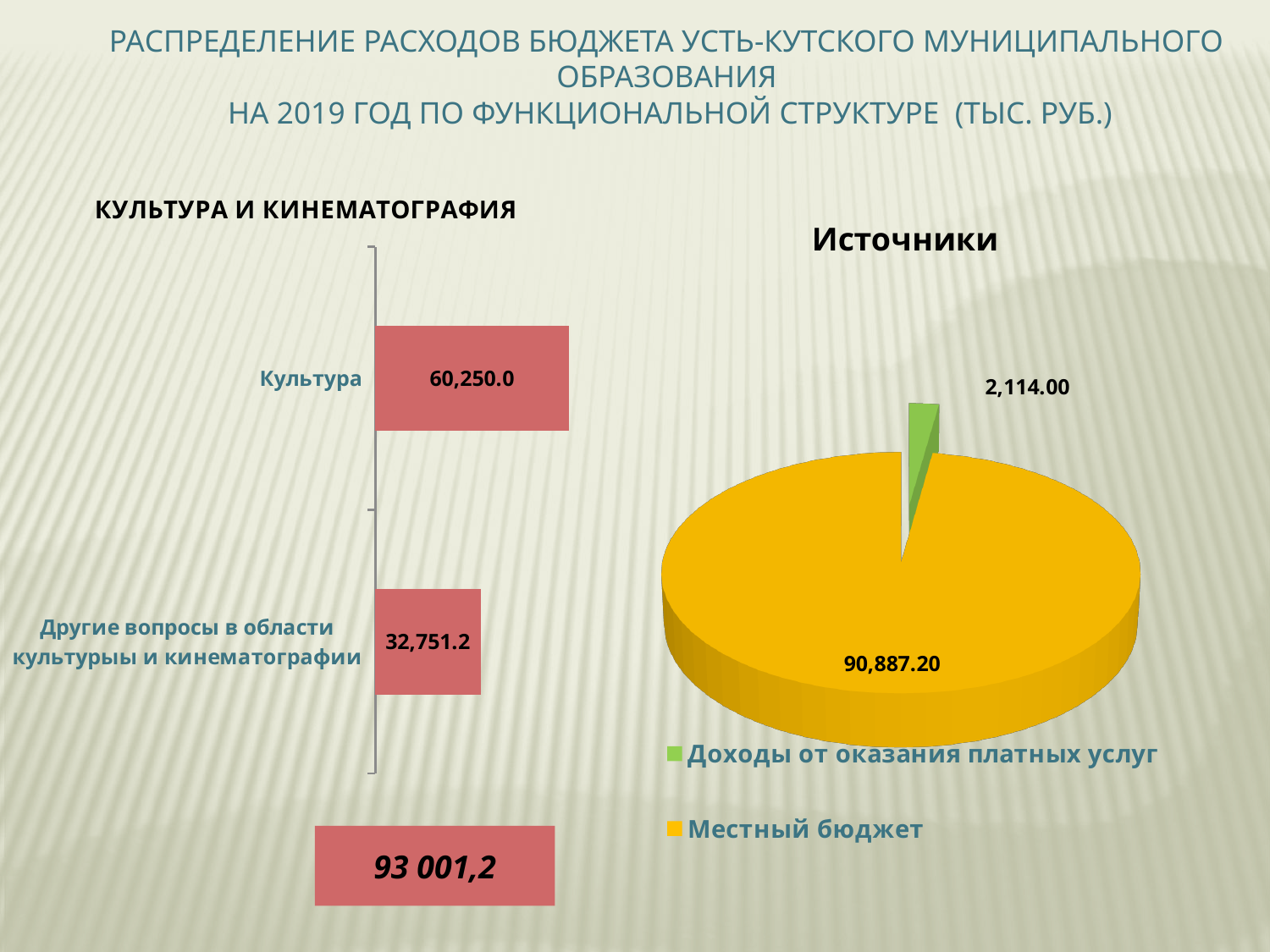
In the chart titled «Источники», what is the value for «Доходы от оказания платных услуг»? 2,114.00 In the chart titled «Источники», what is the value for «Местный бюджет»? 90,887.20 In the chart titled «КУЛЬТУРА И КИНЕМАТОГРАФИЯ», what is the difference between the value for «Культура» and the value for «Другие вопросы в области культурыы и кинематографии»? 27,498.8 In the chart titled «КУЛЬТУРА И КИНЕМАТОГРАФИЯ», which category has the highest value? Культура In the chart titled «КУЛЬТУРА И КИНЕМАТОГРАФИЯ», what is the value for «Другие вопросы в области культурыы и кинематографии»? 32,751.2 In the chart titled «КУЛЬТУРА И КИНЕМАТОГРАФИЯ», how many categories are plotted? 2 In the chart titled «Источники», which slice is the smallest? Доходы от оказания платных услуг What kind of chart is the chart titled «Источники»? Pie chart What kind of chart is the chart titled «КУЛЬТУРА И КИНЕМАТОГРАФИЯ»? Bar chart In the chart titled «Источники», how many entries does the legend list? 2 In the chart titled «Источники», which is larger: «Местный бюджет» or «Доходы от оказания платных услуг»? Местный бюджет In the chart titled «КУЛЬТУРА И КИНЕМАТОГРАФИЯ», what is the value for «Культура»? 60,250.0